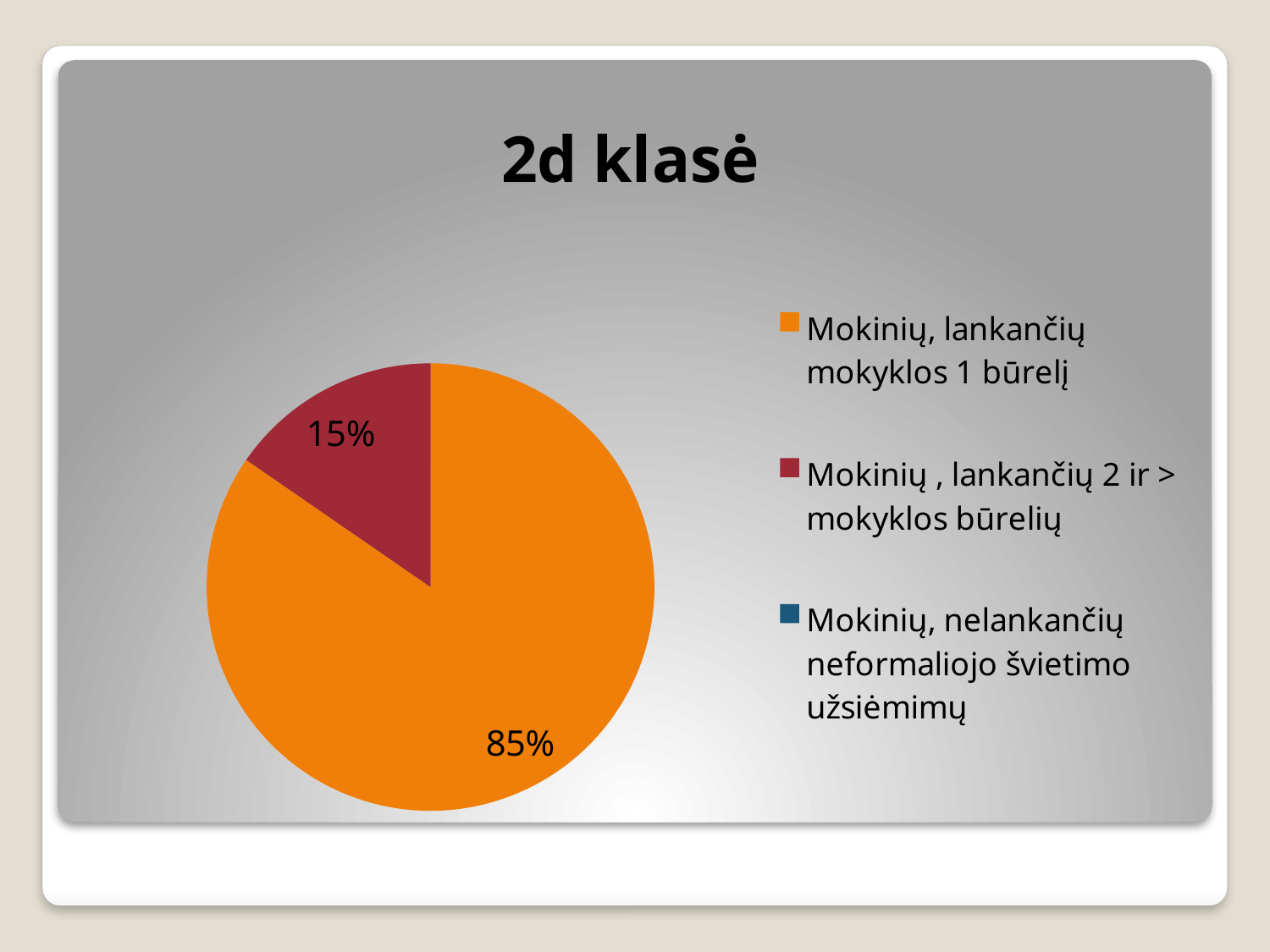
What is the difference in percentage points between the 85% slice and the 15% slice? 70 What share of the pie is labelled for "Mokinių, lankančių mokyklos 1 būrelį"? 85% Which category has the largest slice of the pie? Mokinių, lankančių mokyklos 1 būrelį How many slices with data labels are visible in the pie? 2 What share of the pie is labelled for "Mokinių , lankančių 2 ir > mokyklos būrelių"? 15% How many entries does the legend list? 3 What kind of chart is shown on the slide? pie chart Which is larger: the slice for "Mokinių, lankančių mokyklos 1 būrelį" or the slice for "Mokinių , lankančių 2 ir > mokyklos būrelių"? Mokinių, lankančių mokyklos 1 būrelį Which of the visible slices is the smallest? Mokinių , lankančių 2 ir > mokyklos būrelių What is the title of the slide? 2d klasė What is the combined share of the two labelled slices? 100% What colour is the slice for "Mokinių, lankančių mokyklos 1 būrelį"? orange